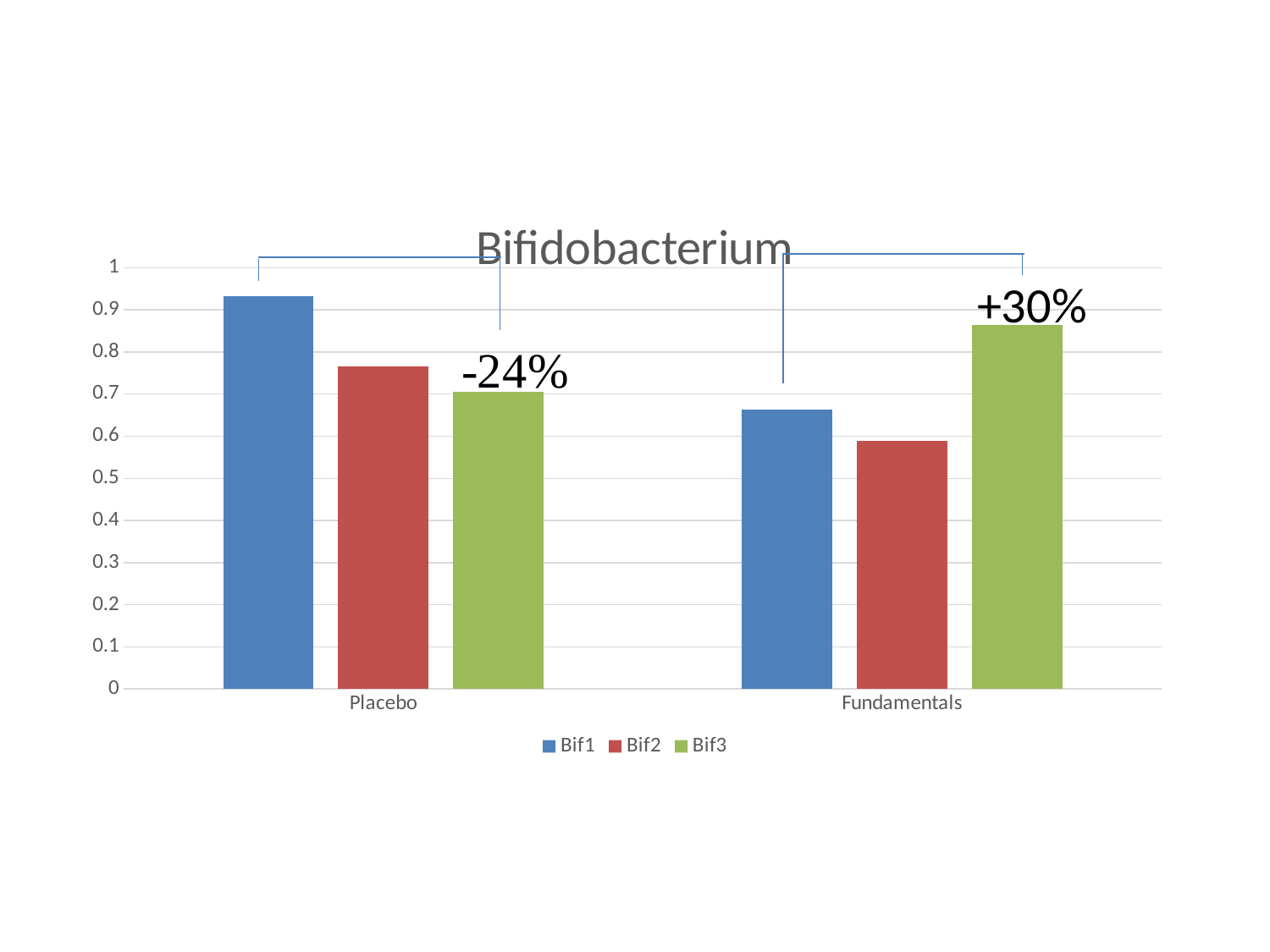
Which is larger: Bif1 for Placebo or Bif1 for Fundamentals? Bif1 for Placebo Which is larger: Bif3 for Placebo or Bif3 for Fundamentals? Bif3 for Fundamentals What kind of chart is shown on the slide? bar chart Is the value for Bif1 in the Placebo category greater or less than 0.9? greater Which series has the highest value in the Placebo category? Bif1 What percentage change is annotated above the Bif3 bar in the Fundamentals category? +30% What is the title of the chart? Bifidobacterium Which series has the lowest value in the Fundamentals category? Bif2 Which series has the highest value in the Fundamentals category? Bif3 How many categories are shown on the x axis? 2 How many series does the legend list? 3